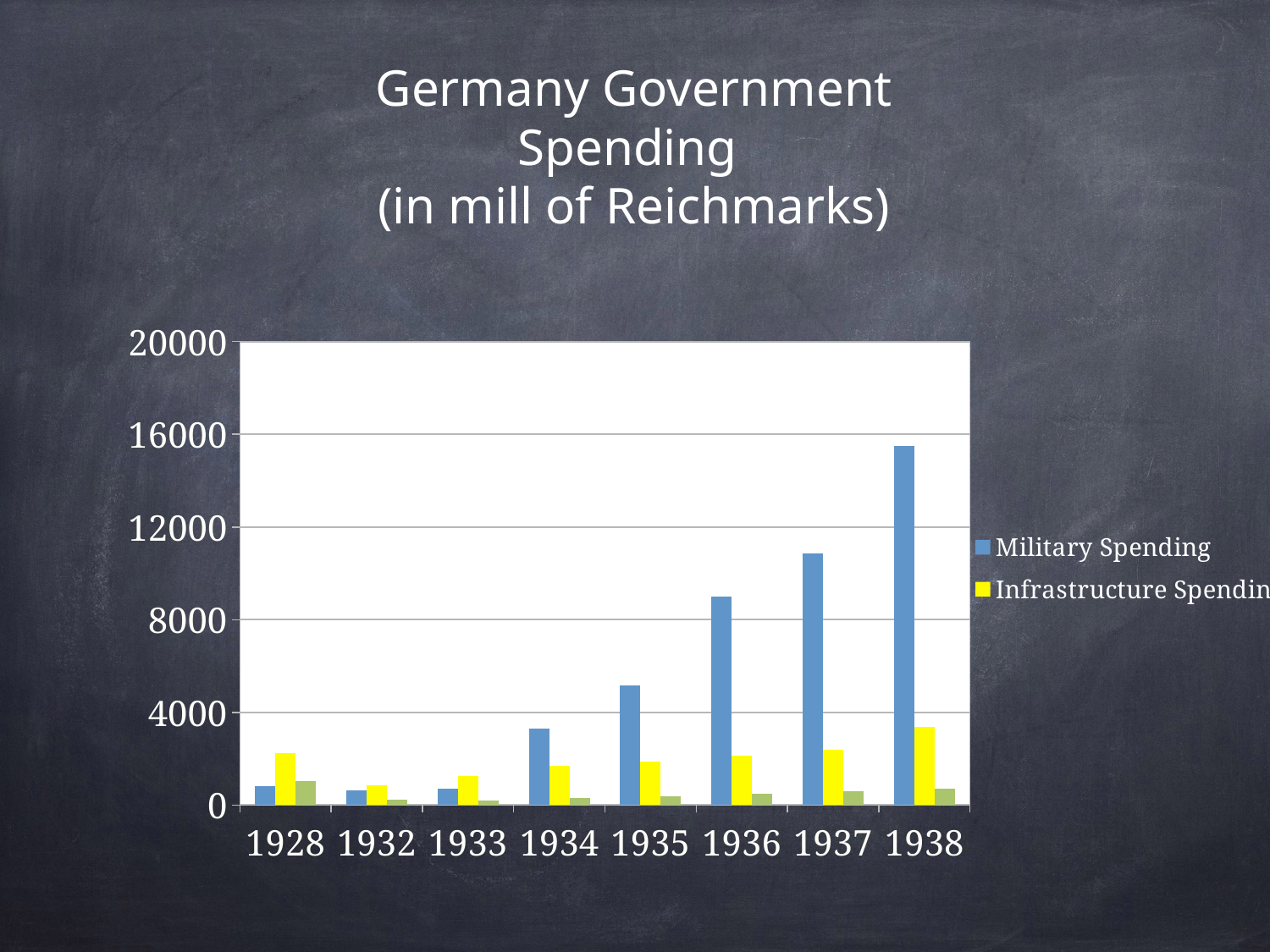
How many series does the chart's legend list? 2 What colour are the Military Spending bars in the chart? blue How many years are shown along the x axis of the chart? 8 What kind of chart is shown on the slide? bar chart Is the Military Spending value for 1938 greater or less than 12000? greater Is the Military Spending value for 1937 greater or less than 8000? greater Is the Military Spending value for 1934 greater or less than 4000? less In which year is Infrastructure Spending highest? 1938 Does Military Spending rise or fall from 1932 to 1938? rise In which year is Military Spending highest? 1938 In 1928, which is larger: Military Spending or Infrastructure Spending? Infrastructure Spending